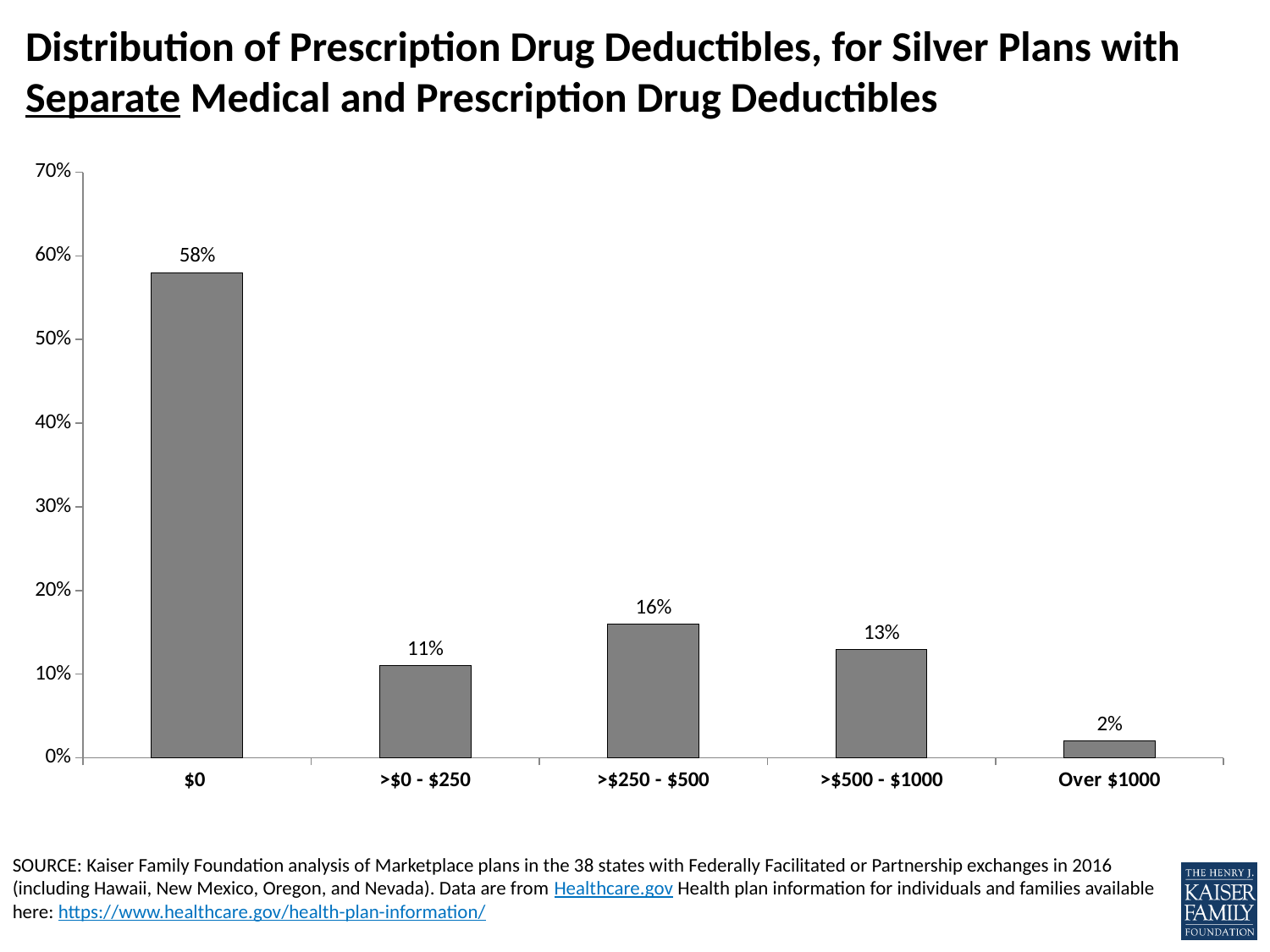
What is the difference between the >$250 - $500 and >$500 - $1000 categories? 3% What is the difference between the $0 category and the >$0 - $250 category? 47% Is the value for the $0 category greater or less than 50%? greater What is the value for the Over $1000 category? 2% What kind of chart is shown on the slide? Bar chart What is the value for the >$250 - $500 category? 16% Which deductible category has the highest share of plans? $0 How many deductible categories are shown on the x axis? 5 Which is larger, the value for >$0 - $250 or the value for >$500 - $1000? >$500 - $1000 What percentage of silver plans with separate deductibles have a $0 prescription drug deductible? 58% What is the highest value shown on the y axis? 70% Which deductible category has the lowest share of plans? Over $1000